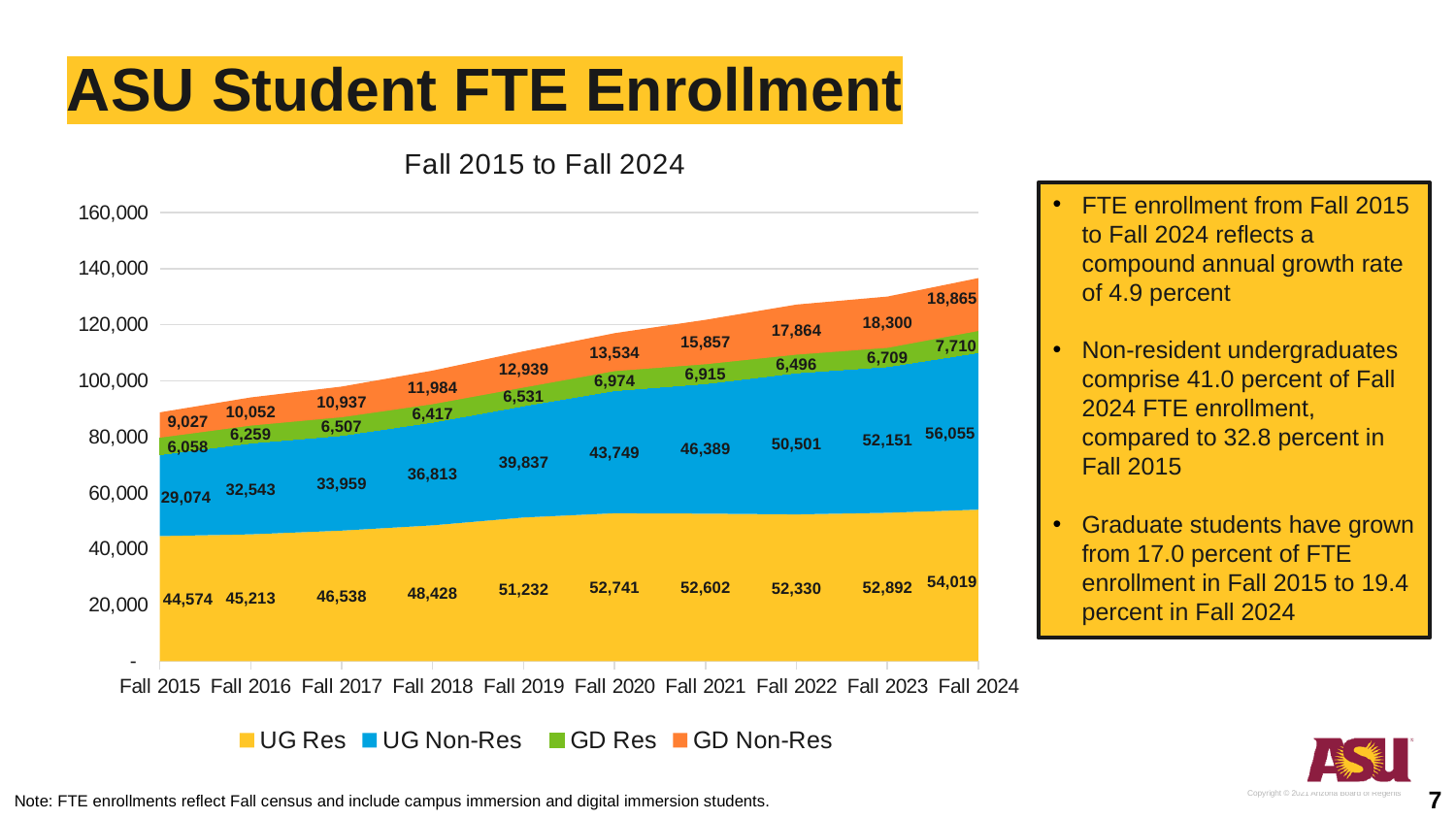
How many years (data points) are shown on the x axis? 10 What kind of chart is shown? Stacked area chart Does the GD Non-Res value rise or fall from Fall 2015 to Fall 2024? Rise What is the total FTE enrollment across all four series for Fall 2024? 136,649 What is the UG Res value for Fall 2019? 51,232 What is the UG Non-Res value for Fall 2015? 29,074 What is the difference between the UG Non-Res values for Fall 2024 and Fall 2015? 26,981 What is the GD Non-Res value for Fall 2021? 15,857 In which year is the GD Res value lowest? Fall 2015 In which year is the UG Non-Res value highest? Fall 2024 In Fall 2024, which is larger: UG Res or UG Non-Res? UG Non-Res How many series does the legend list? 4